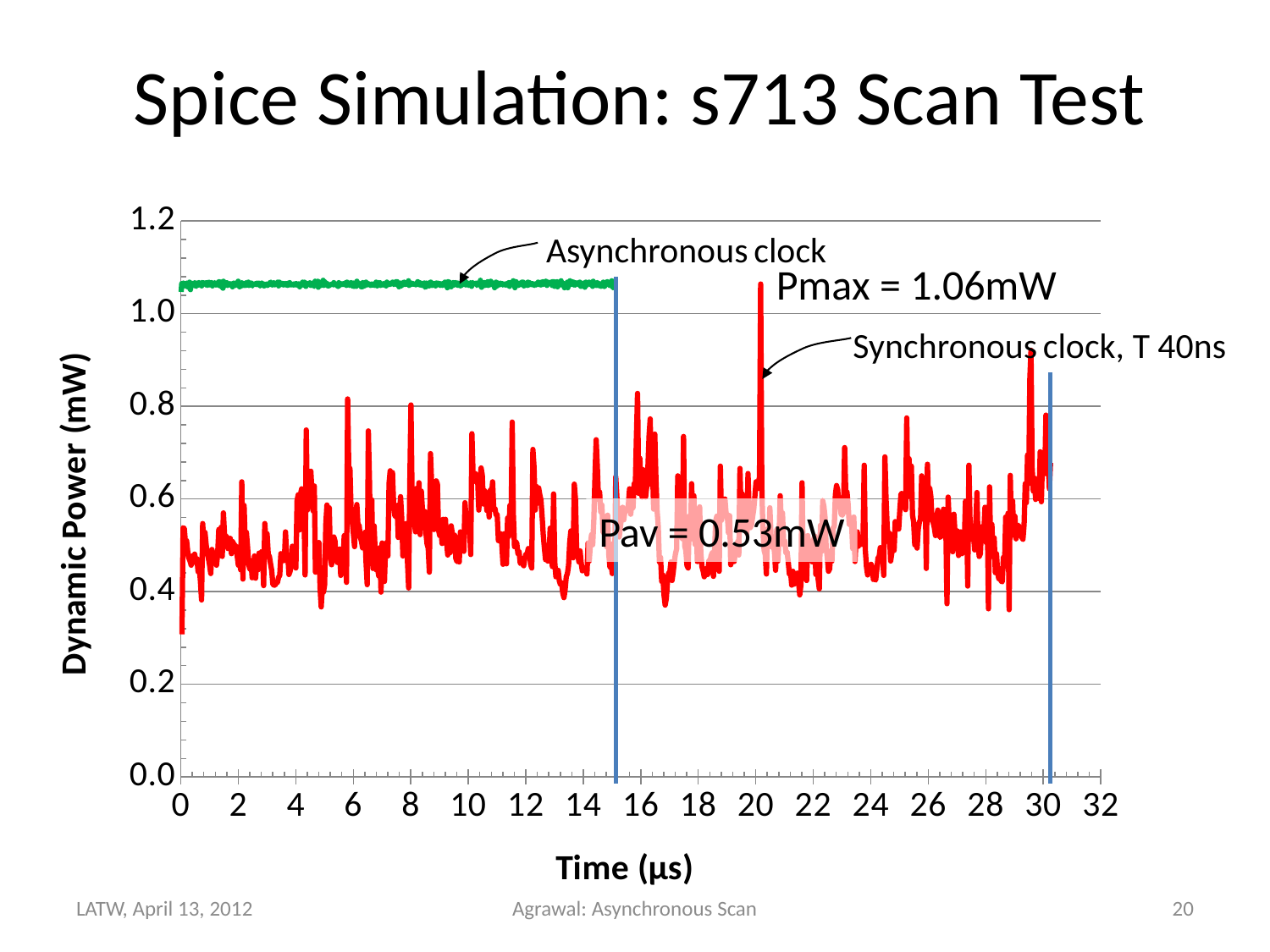
What is the highest tick value shown on the x axis? 32 How many clock series are labelled on the chart? 2 What is the title of the slide's chart? Spice Simulation: s713 Scan Test What is the Pav value annotated on the chart? 0.53mW What kind of chart is shown on the slide? line chart Does the Asynchronous clock line rise, fall, or stay flat along the time axis? stay flat What is the clock period given for the Synchronous clock series? T 40ns At time 10 µs, which series has the higher dynamic power, the Asynchronous clock or the Synchronous clock? Asynchronous clock At time 10 µs, is the Synchronous clock value greater or less than 1.0 mW? less What is the label of the y axis? Dynamic Power (mW) What is the Pmax value annotated on the chart? 1.06mW Is the value of the Asynchronous clock line greater or less than 1.0 mW? greater